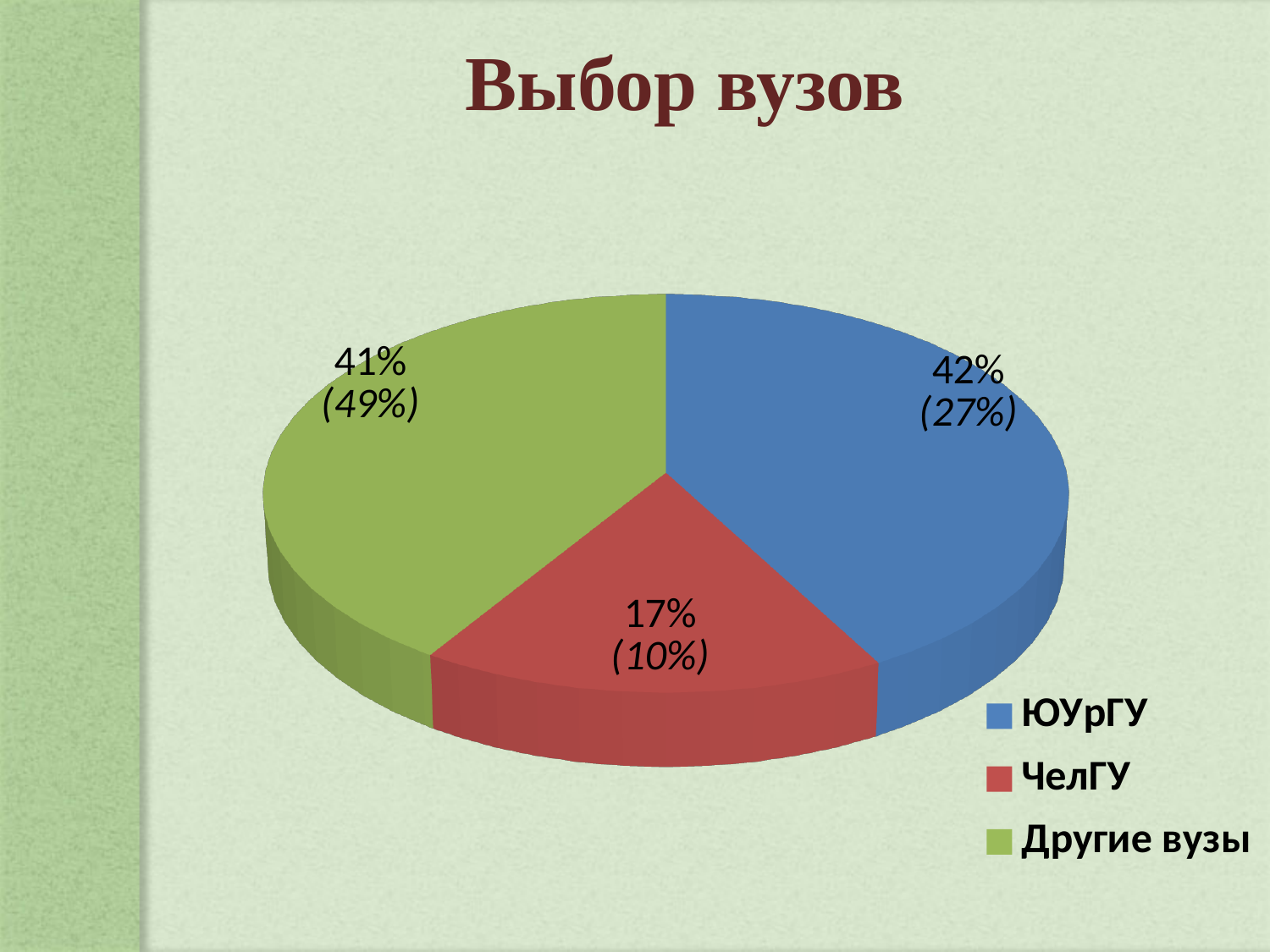
What is the difference between the main percentages for ЮУрГУ and ЧелГУ? 25% How many entries does the legend list? 3 Which category has the largest slice according to the main percentage labels? ЮУрГУ What value is shown in parentheses for the ЧелГУ slice? (10%) What type of chart is shown on the slide? pie chart How many slices does the pie chart have? 3 Which category has the smallest slice of the pie? ЧелГУ What value is shown in parentheses for the Другие вузы slice? (49%) What percentage is shown for ЧелГУ (the main label, not in parentheses)? 17% What percentage is shown for Другие вузы (the main label, not in parentheses)? 41% What is the title of the chart? Выбор вузов What percentage is shown for ЮУрГУ (the main label, not in parentheses)? 42%